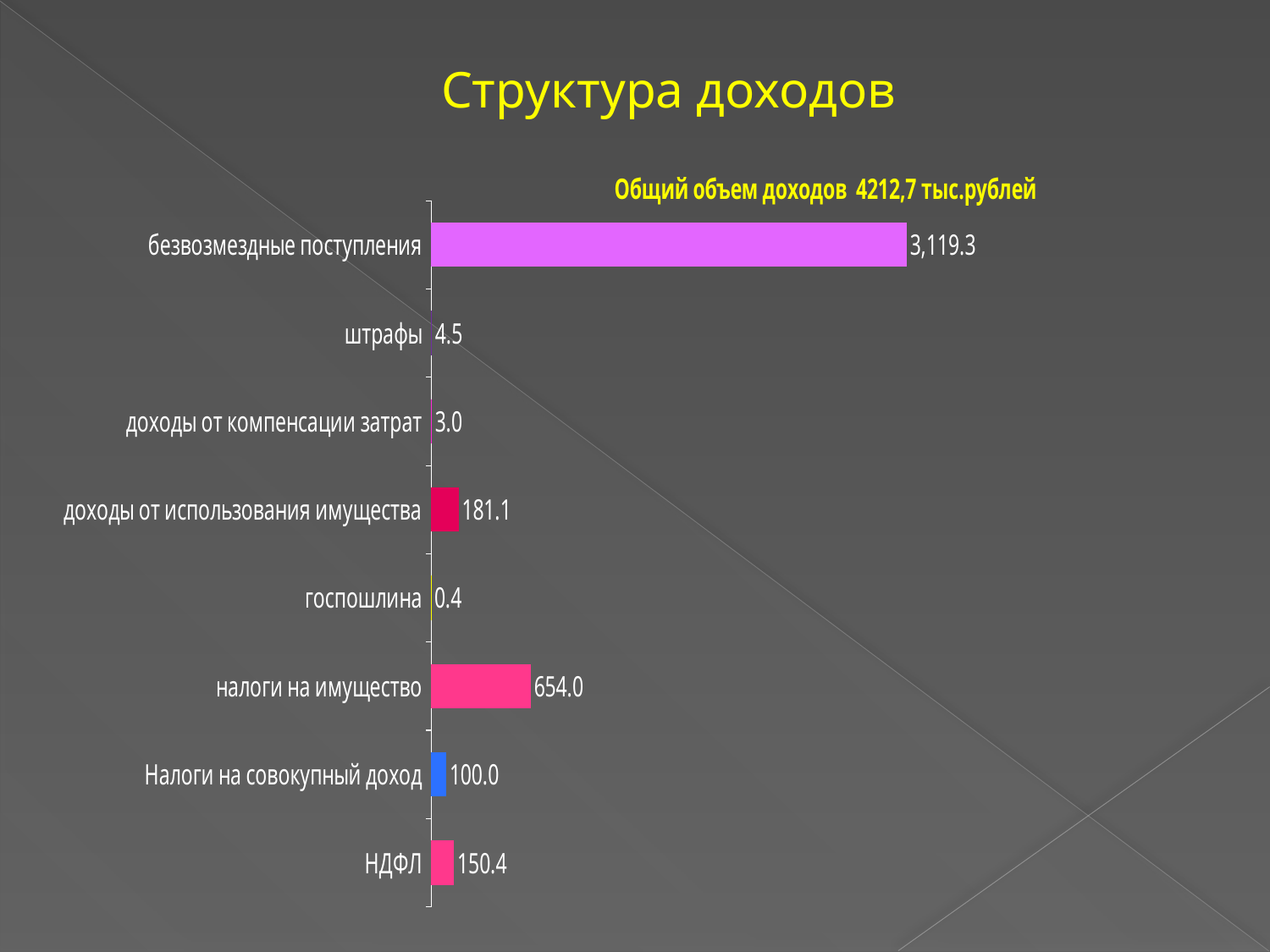
How many categories are shown in the chart? 8 What is the value for госпошлина? 0.4 What is the difference between налоги на имущество and Налоги на совокупный доход? 554.0 What total income amount is stated above the chart? 4212,7 тыс.рублей What is the value for безвозмездные поступления? 3,119.3 What kind of chart is shown on the slide? bar chart What is the value for НДФЛ? 150.4 What is the value for налоги на имущество? 654.0 Which is larger, штрафы or доходы от компенсации затрат? штрафы Which category has the lowest value? госпошлина What is the difference between доходы от использования имущества and НДФЛ? 30.7 Which category has the highest value? безвозмездные поступления